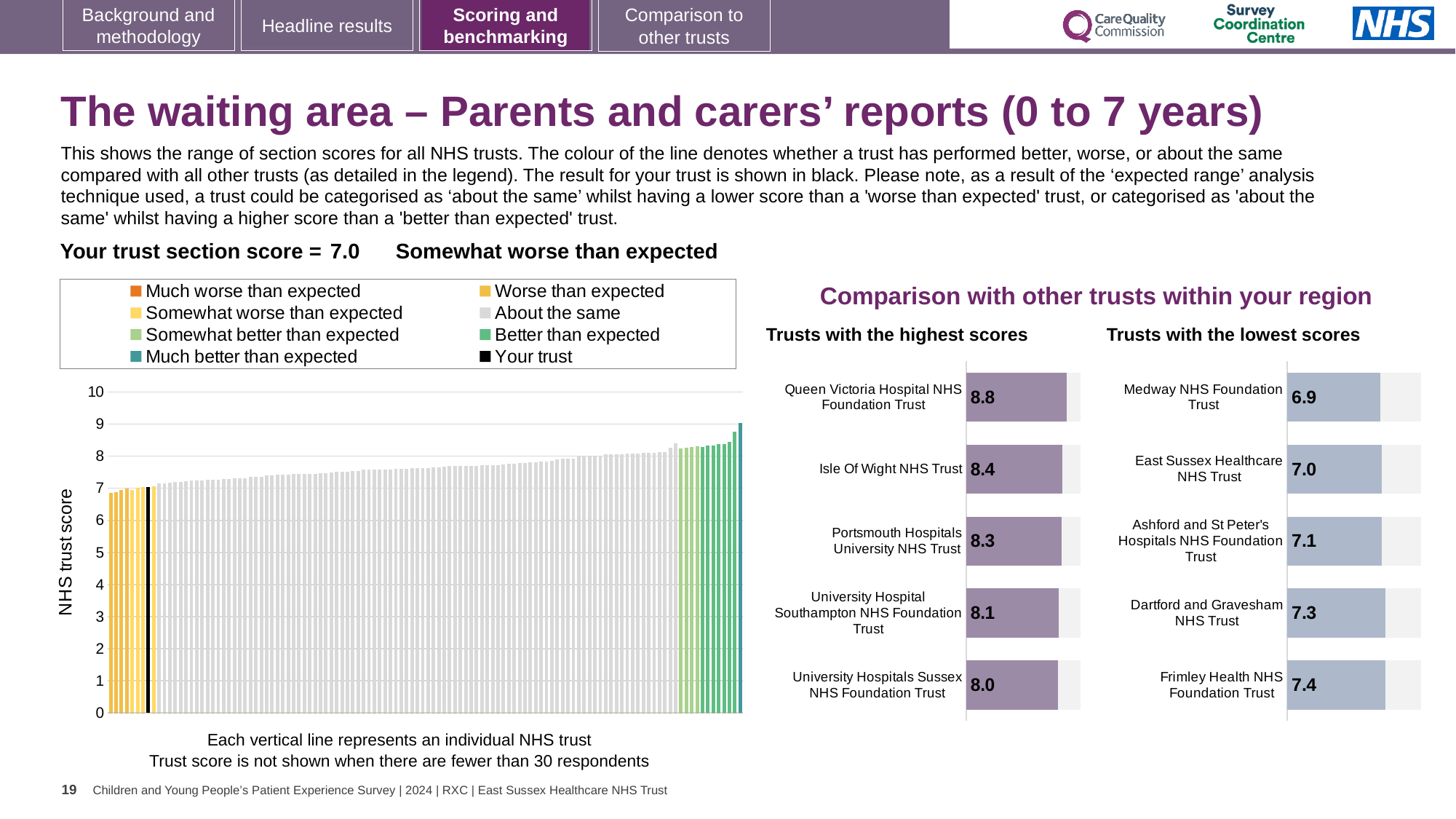
What kind of chart is the main chart on the left showing all NHS trusts? bar chart In the 'Trusts with the highest scores' chart, what is the difference between the scores of Queen Victoria Hospital NHS Foundation Trust and Isle Of Wight NHS Trust? 0.4 How many trusts are listed in the 'Trusts with the lowest scores' chart? 5 How many entries does the legend above the main chart on the left list? 8 In the 'Trusts with the lowest scores' chart, what is the score for Medway NHS Foundation Trust? 6.9 In the 'Trusts with the lowest scores' chart, which has the larger score: Ashford and St Peter's Hospitals NHS Foundation Trust or Dartford and Gravesham NHS Trust? Dartford and Gravesham NHS Trust In the main chart on the left showing all NHS trusts, is the value of the tallest bar greater or less than 8? greater In the main chart on the left showing all NHS trusts, what is the section score for your trust (the black bar)? 7.0 In the 'Trusts with the lowest scores' chart, what is the score for East Sussex Healthcare NHS Trust? 7.0 In the 'Trusts with the lowest scores' chart, which trust has the highest score shown? Frimley Health NHS Foundation Trust In the 'Trusts with the highest scores' chart, what is the score for Queen Victoria Hospital NHS Foundation Trust? 8.8 In the 'Trusts with the highest scores' chart, which trust has the lowest score shown? University Hospitals Sussex NHS Foundation Trust